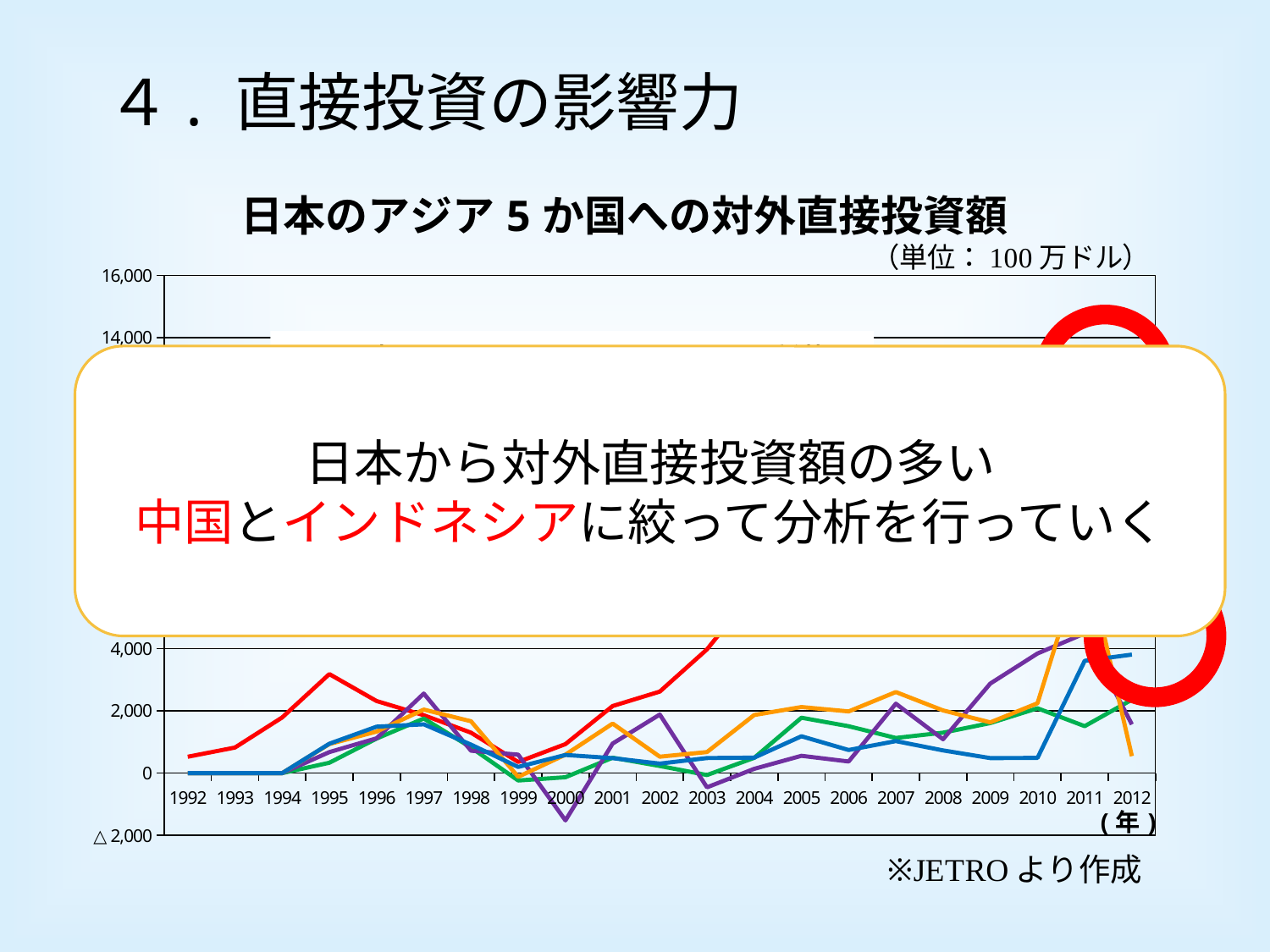
What is the last year shown on the x axis? 2012 In 1992, are all plotted values greater or less than 2,000? less Is the highest plotted value in 1995 greater or less than 2,000? greater What unit is stated for the values in the chart? 100万ドル Is the lowest plotted value in 2000 greater or less than 0? less How many lines (series) are plotted in the chart? 5 What kind of chart is shown on the slide? Line chart How many years are shown along the x axis of the chart? 21 What is the title of the chart? 日本のアジア5か国への対外直接投資額 What is the first year shown on the x axis? 1992